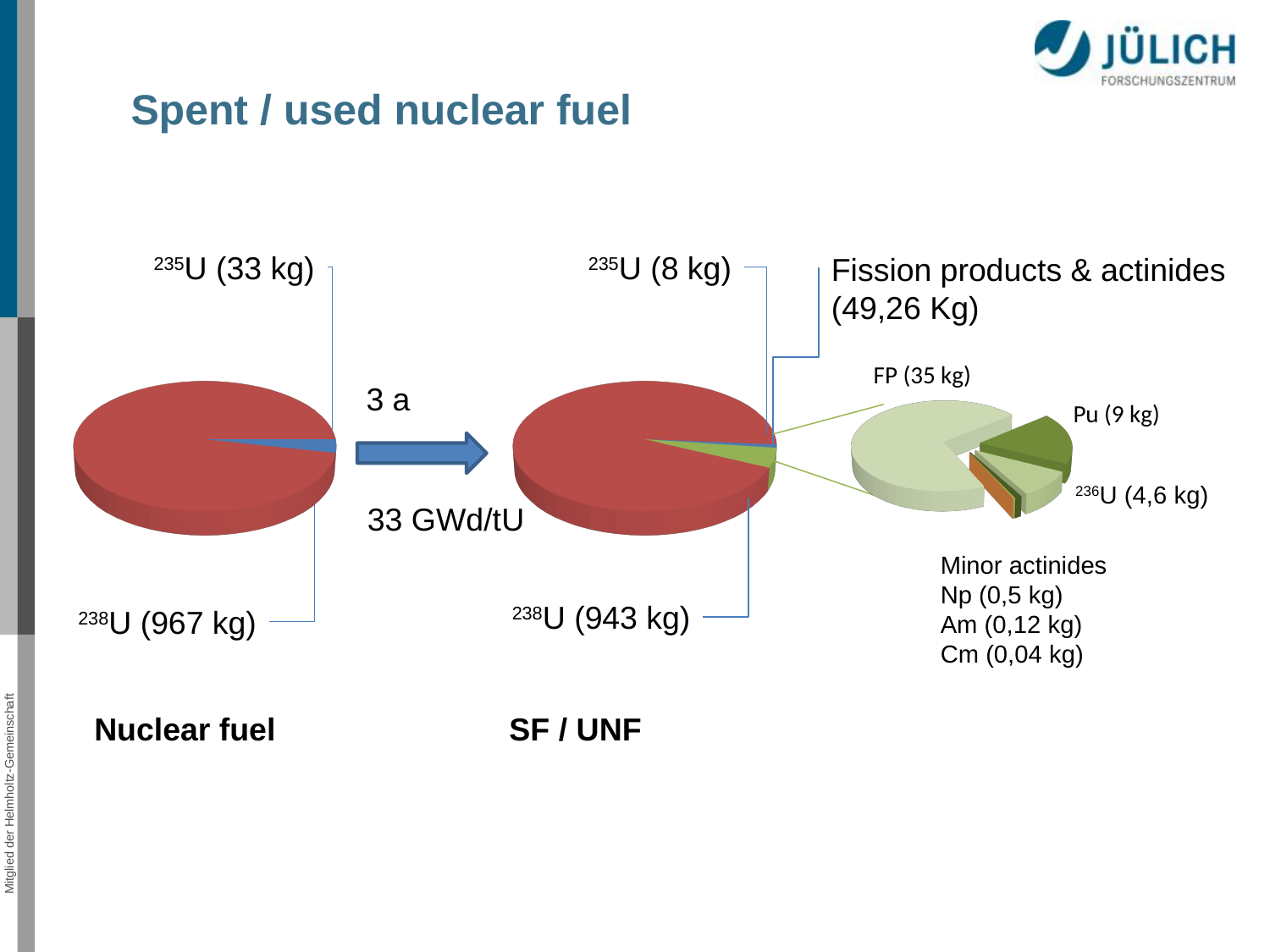
In the Nuclear fuel pie chart, what is the value for 235U? 33 kg In the breakdown pie chart on the right, which labelled component has the largest value? FP In the SF / UNF pie chart, what is the value for Fission products & actinides? 49,26 Kg In the Nuclear fuel pie chart, what is the value for 238U? 967 kg What kind of chart is used for the Nuclear fuel and SF / UNF diagrams? Pie chart In the breakdown pie chart on the right, what is the value for Pu? 9 kg In the SF / UNF pie chart, what is the value for 238U? 943 kg In the breakdown pie chart on the right, what is the value for FP? 35 kg Which is larger: the 235U value in the Nuclear fuel pie chart or the 235U value in the SF / UNF pie chart? Nuclear fuel In the breakdown pie chart on the right, what is the value for 236U? 4,6 kg What is the difference between the 238U value in the Nuclear fuel pie chart and the 238U value in the SF / UNF pie chart? 24 kg In the SF / UNF pie chart, what is the value for 235U? 8 kg